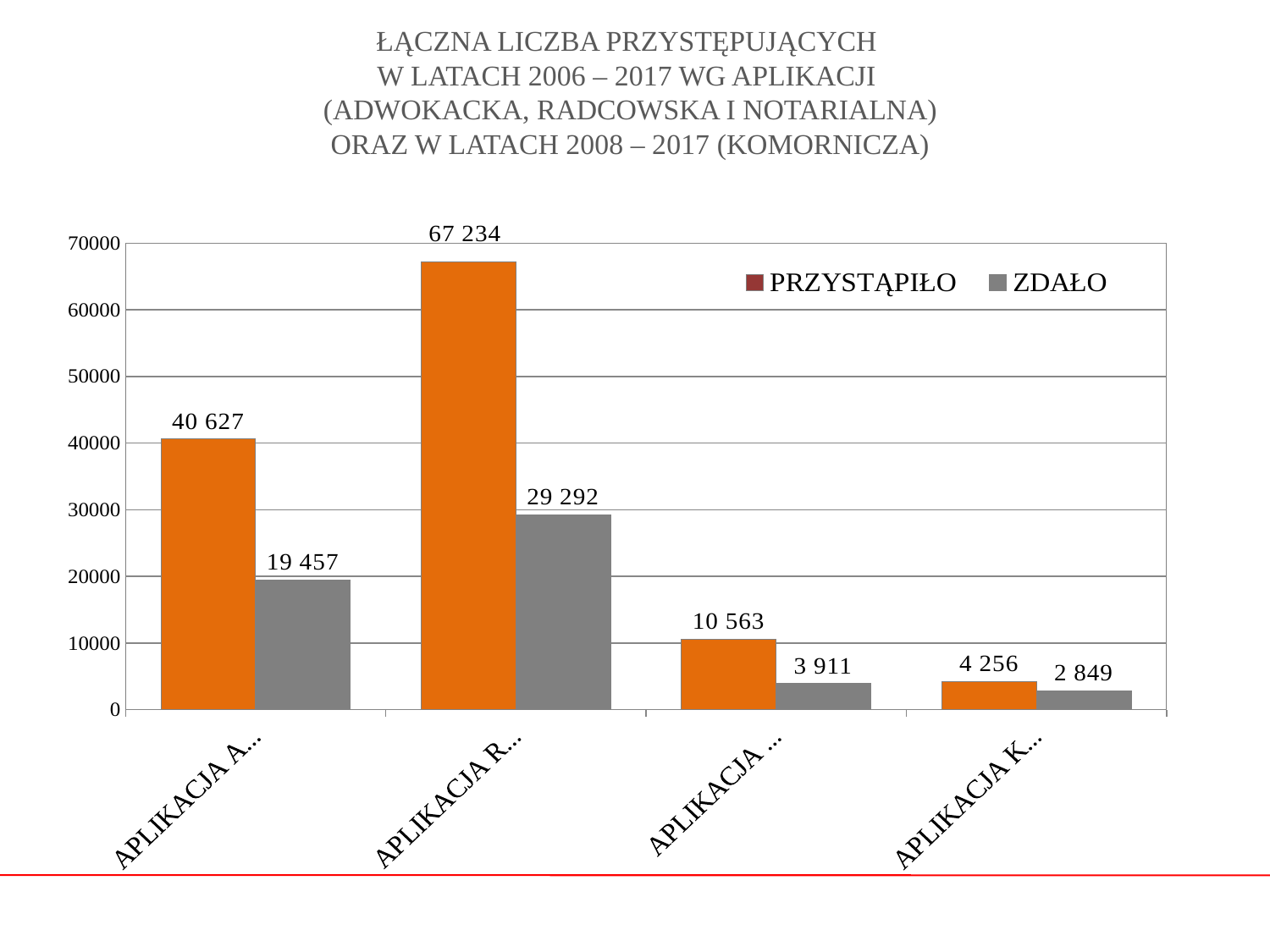
What is the ZDAŁO value for the last category (APLIKACJA K...)? 2 849 What is the PRZYSTĄPIŁO value for the second category (APLIKACJA R...)? 67 234 What kind of chart is shown on the slide? Bar chart How many categories are shown on the x axis? 4 What is the difference between PRZYSTĄPIŁO and ZDAŁO for the second category (APLIKACJA R...)? 37 942 What is the ZDAŁO value for the first category (APLIKACJA A...)? 19 457 Which category has the lowest ZDAŁO value? APLIKACJA K... (the fourth category) What is the PRZYSTĄPIŁO value for the third category from the left? 10 563 Which is larger: the ZDAŁO value for the first category or the ZDAŁO value for the third category? The first category (19 457) Which category has the highest PRZYSTĄPIŁO value? APLIKACJA R... (the second category) How many series does the legend list? 2 What is the difference between PRZYSTĄPIŁO and ZDAŁO for the first category (APLIKACJA A...)? 21 170